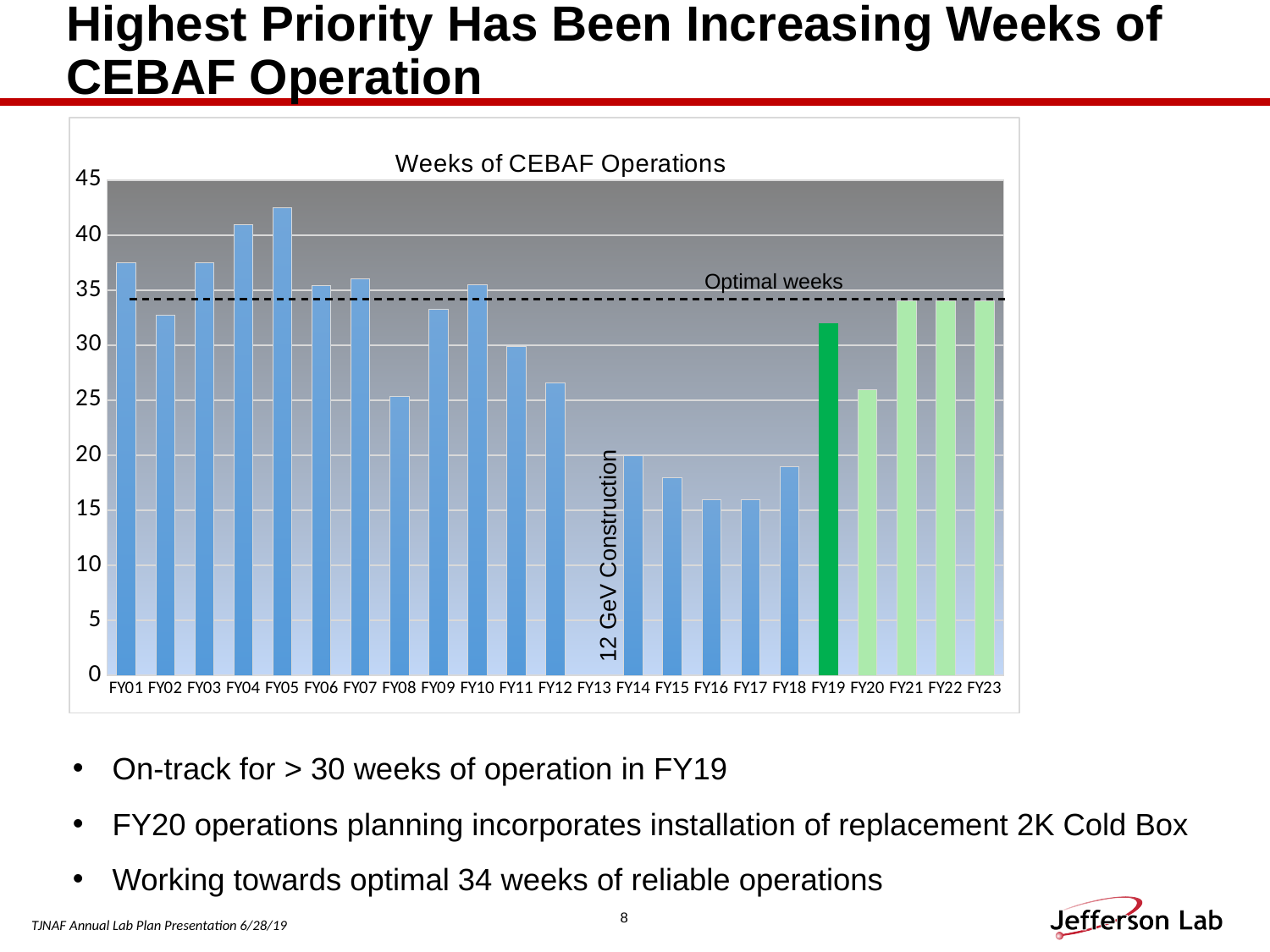
What is the title of the chart? Weeks of CEBAF Operations Which has more weeks of operation, FY02 or FY04? FY04 What label appears in place of a bar for FY13? 12 GeV Construction Which fiscal year has the highest number of weeks of CEBAF operations? FY05 Is the value for FY19 greater or less than 30? greater Is the value for FY04 greater or less than 40? greater Is the value for FY15 greater or less than 20? less How many fiscal years are labelled on the x axis of the chart? 23 Do the values rise or fall from FY10 to FY12? fall What type of chart is shown on the slide? bar chart Which has more weeks of operation, FY19 or FY20? FY19